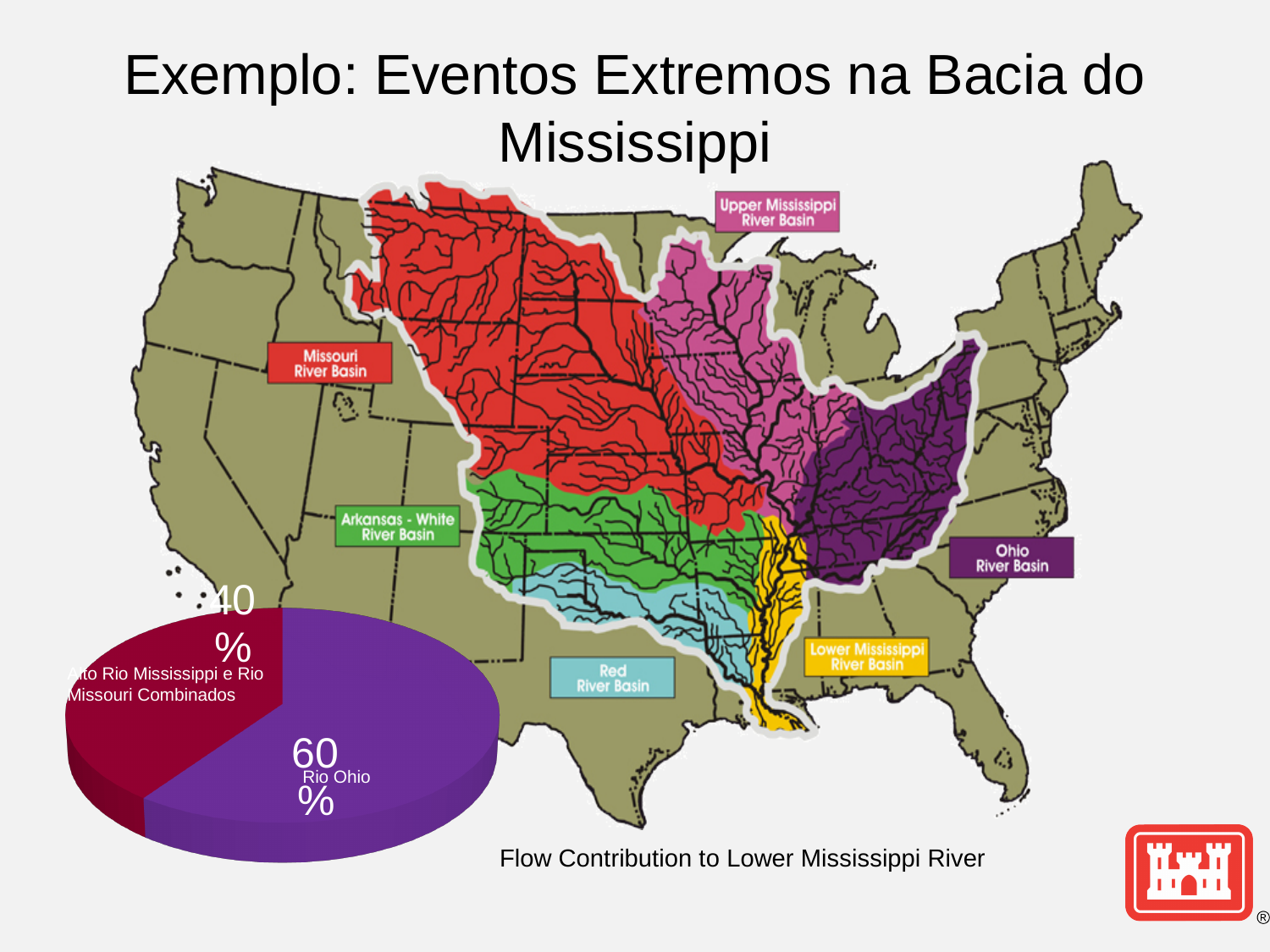
What colour is the Rio Ohio slice of the pie chart? purple What is the caption below the pie chart? Flow Contribution to Lower Mississippi River What is the difference in percentage points between the Rio Ohio slice and the Alto Rio Mississippi e Rio Missouri Combinados slice? 20 How many slices does the pie chart have? 2 What share of the pie chart does Rio Ohio account for? 60% Which slice of the pie chart is the largest? Rio Ohio What share of the pie chart does Alto Rio Mississippi e Rio Missouri Combinados account for? 40% Which slice of the pie chart is the smallest? Alto Rio Mississippi e Rio Missouri Combinados What kind of chart is shown at the bottom left of the slide? pie chart Which is larger in the pie chart: Rio Ohio or Alto Rio Mississippi e Rio Missouri Combinados? Rio Ohio